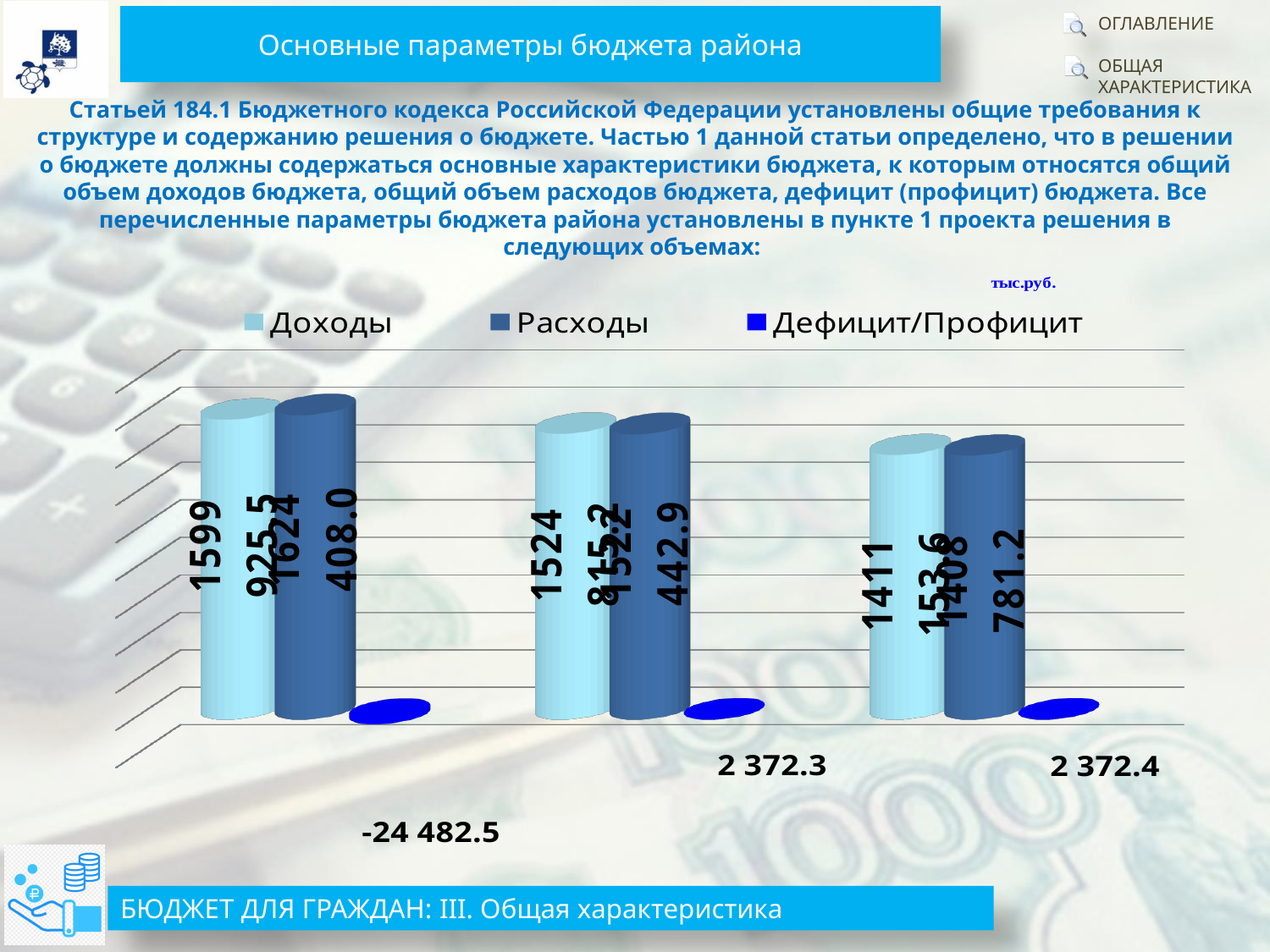
What is the value of Доходы for the third group of bars? 1411 153.6 How many series does the chart legend list? 3 How many groups of bars are plotted in the chart? 3 In the first group of bars, which is larger: Доходы or Расходы? Расходы What unit is indicated above the chart? тыс.руб. What is the value of Дефицит/Профицит for the second group of bars? 2 372.3 What is the value of Дефицит/Профицит for the first group of bars? -24 482.5 What is the value of Дефицит/Профицит for the third group of bars? 2 372.4 What kind of chart is shown on the slide? bar chart Which group of bars has the highest Доходы value? the first group Do the Доходы values rise or fall from the first group to the third group? fall What is the value of Расходы for the first group of bars? 1624 408.0